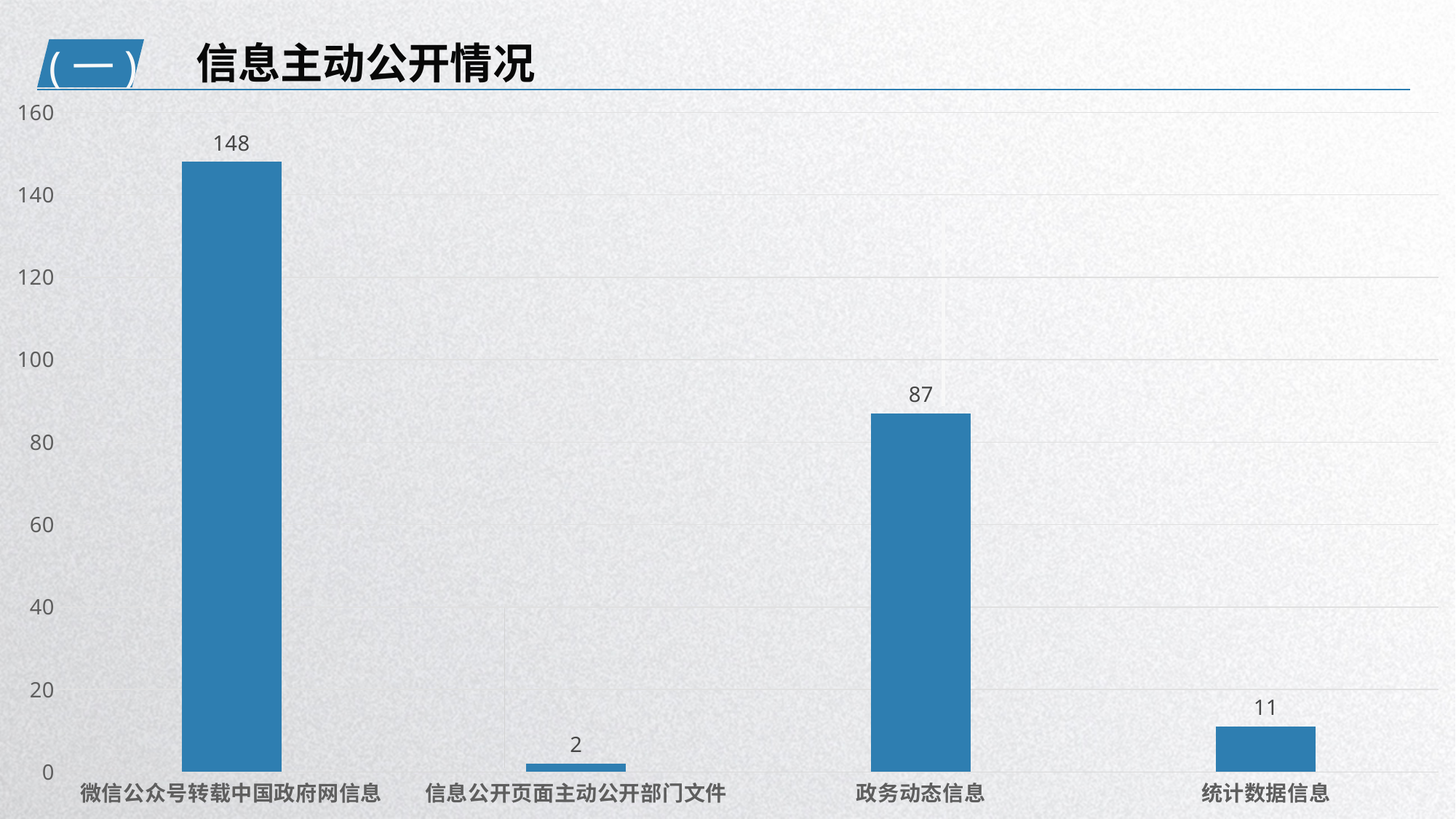
Which is larger, the value for 政务动态信息 or the value for 统计数据信息? 政务动态信息 What is the value for 政务动态信息? 87 How many categories are shown in the chart? 4 Which category has the lowest value? 信息公开页面主动公开部门文件 Which category has the highest value? 微信公众号转载中国政府网信息 What is the value for 微信公众号转载中国政府网信息? 148 What is the title of the slide? 信息主动公开情况 What is the difference between the values for 微信公众号转载中国政府网信息 and 政务动态信息? 61 What kind of chart is shown on the slide? bar chart Is the value for 政务动态信息 greater or less than 100? less What is the value for 统计数据信息? 11 What is the value for 信息公开页面主动公开部门文件? 2